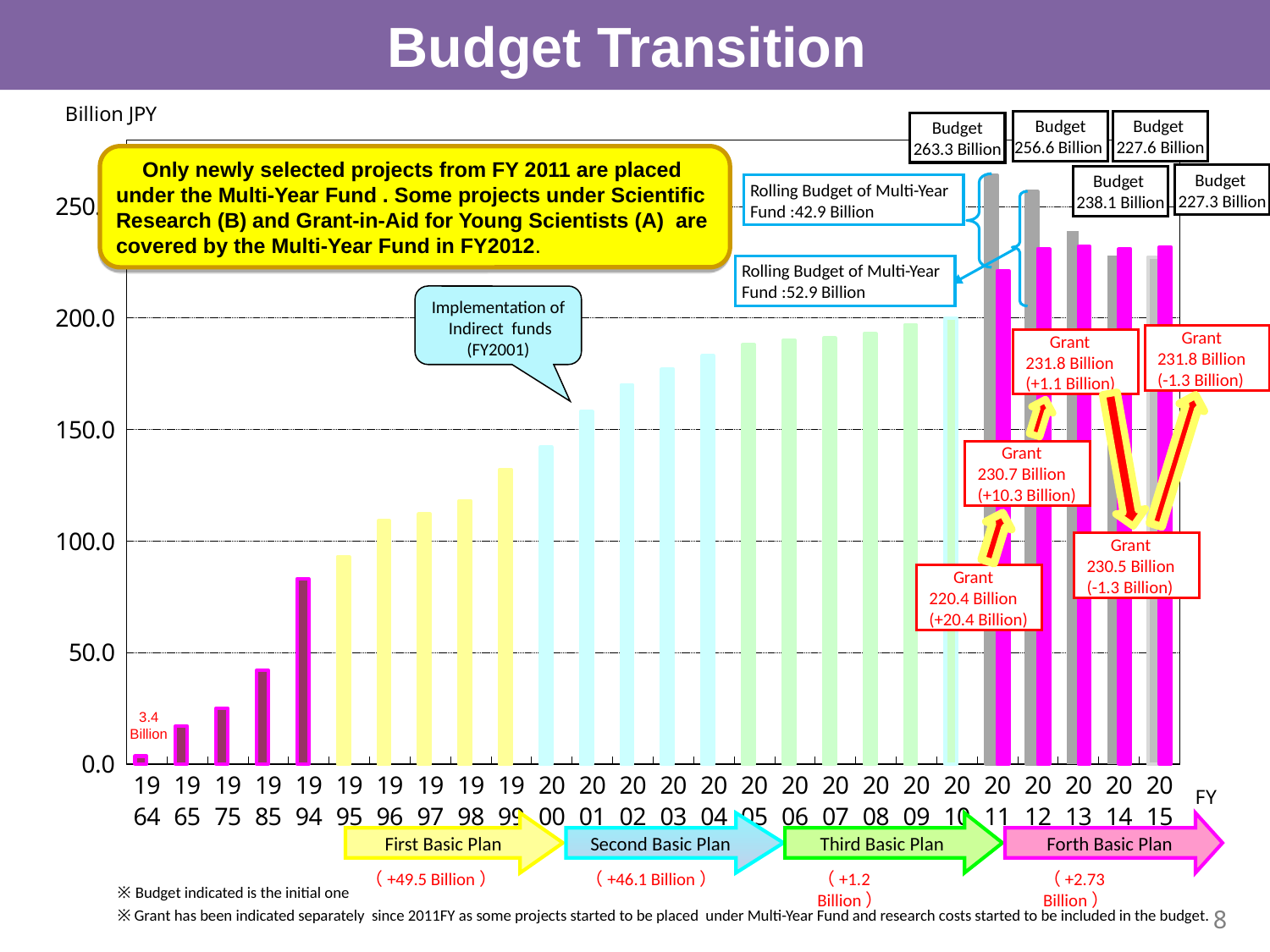
What is the difference between the FY2011 budget and the FY2012 budget? 6.7 Billion What is the budget shown for FY2012? 256.6 Billion Which fiscal year has the highest budget bar? 2011 What is the budget shown for FY2015? 227.3 Billion What is the budget shown for FY2011? 263.3 Billion What is the value shown for FY1964? 3.4 Billion What is the grant amount shown for FY2011? 220.4 Billion Which fiscal year has the lowest bar? 1964 Is the value for FY2000 greater or less than 150.0? less Is the value for FY1994 greater or less than 100.0? less Do the bars rise or fall from FY1995 to FY2010? rise What kind of chart is shown on the slide? bar chart